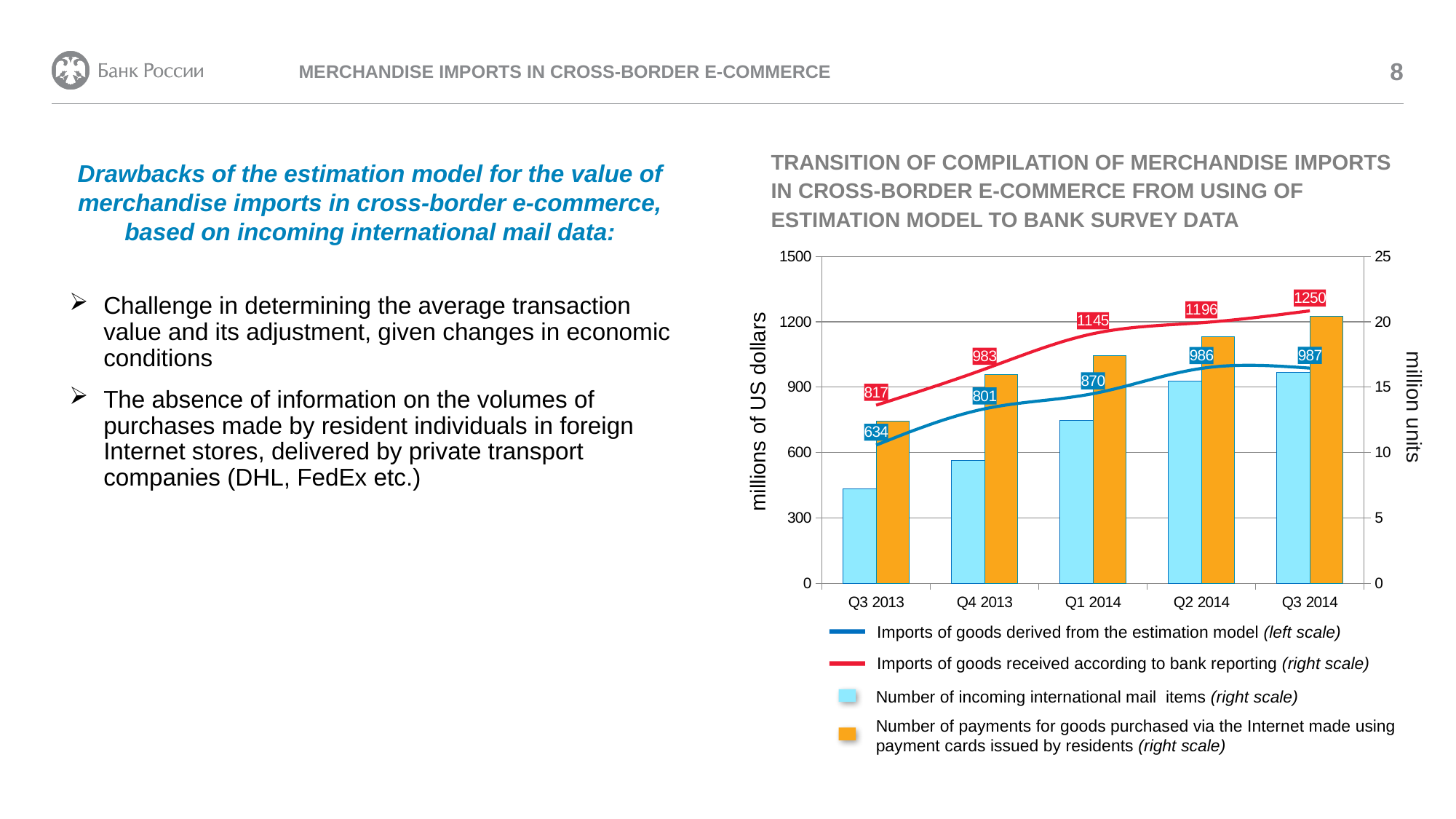
How many quarters are shown on the x axis of the chart? 5 In which quarter is the value of imports of goods derived from the estimation model lowest? Q3 2013 Does the value of imports of goods received according to bank reporting rise or fall from Q3 2013 to Q3 2014? rise Is the number of payments for goods purchased via the Internet made using payment cards in Q3 2014 greater or less than 20 million units? greater How many series does the chart legend list? 4 Is the number of incoming international mail items in Q3 2013 greater or less than 10 million units? less In which quarter is the value of imports of goods received according to bank reporting highest? Q3 2014 What is the value of imports of goods derived from the estimation model in Q3 2013? 634 What is the difference between imports according to bank reporting and imports from the estimation model in Q2 2014? 210 Which is larger in Q4 2013: imports from the estimation model or imports according to bank reporting? Imports according to bank reporting What is the value of imports of goods received according to bank reporting in Q1 2014? 1145 What is the value of imports of goods received according to bank reporting in Q3 2014? 1250